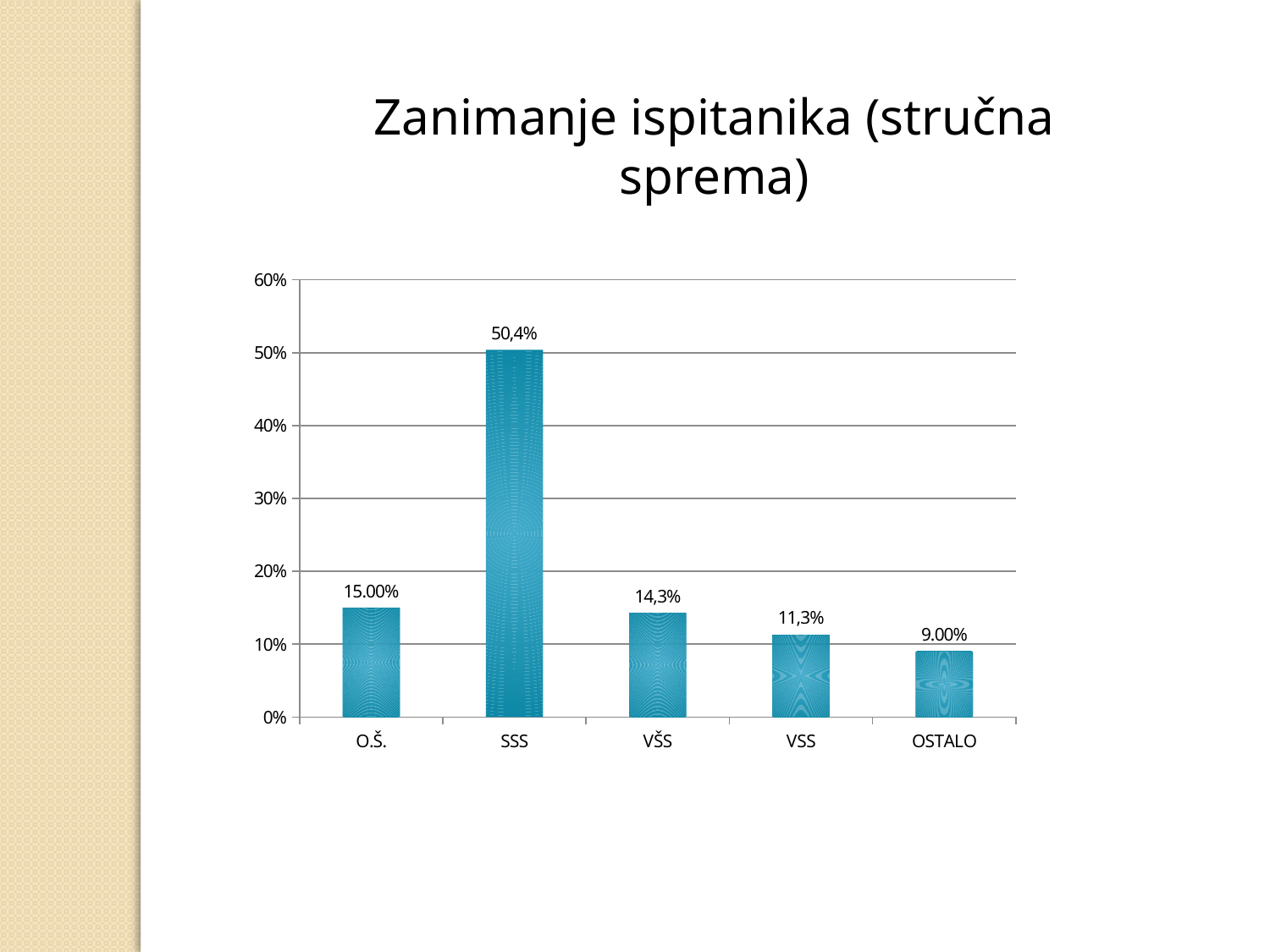
What is the value for SSS? 50,4% What is the value for VSS? 11,3% Which category has the highest value? SSS What kind of chart is shown on the slide? bar chart What is the value for VŠS? 14,3% What is the value for O.Š.? 15.00% Is the value for SSS greater or less than 50%? greater Which is larger, the value for VŠS or the value for VSS? VŠS How many categories are shown on the x axis? 5 Which category has the lowest value? OSTALO What is the title of the chart on the slide? Zanimanje ispitanika (stručna sprema) What is the value for OSTALO? 9.00%